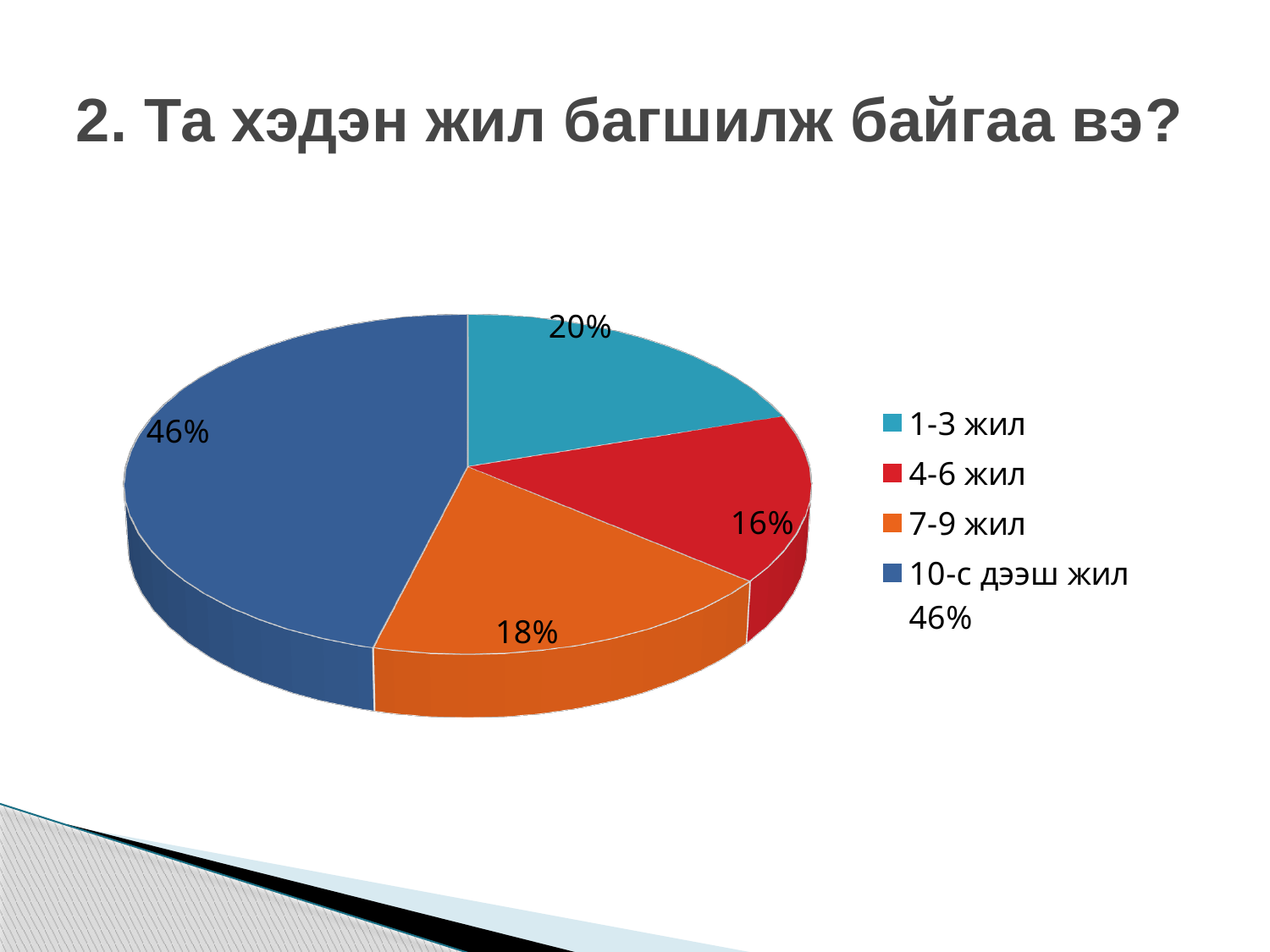
Which category has the smallest slice of the pie? 4-6 жил What share of the pie does the "7-9 жил" slice have? 18% What share of the pie does the "10-с дээш жил" slice have? 46% Which category has the largest slice of the pie? 10-с дээш жил How many slices does the pie chart have? 4 What colour is the "10-с дээш жил" slice? dark blue Which slice is larger, "7-9 жил" or "4-6 жил"? 7-9 жил What share of the pie does the "1-3 жил" slice have? 20% What kind of chart is shown on the slide? pie chart What is the difference in percentage points between the "10-с дээш жил" slice and the "1-3 жил" slice? 26% How many entries does the legend list? 4